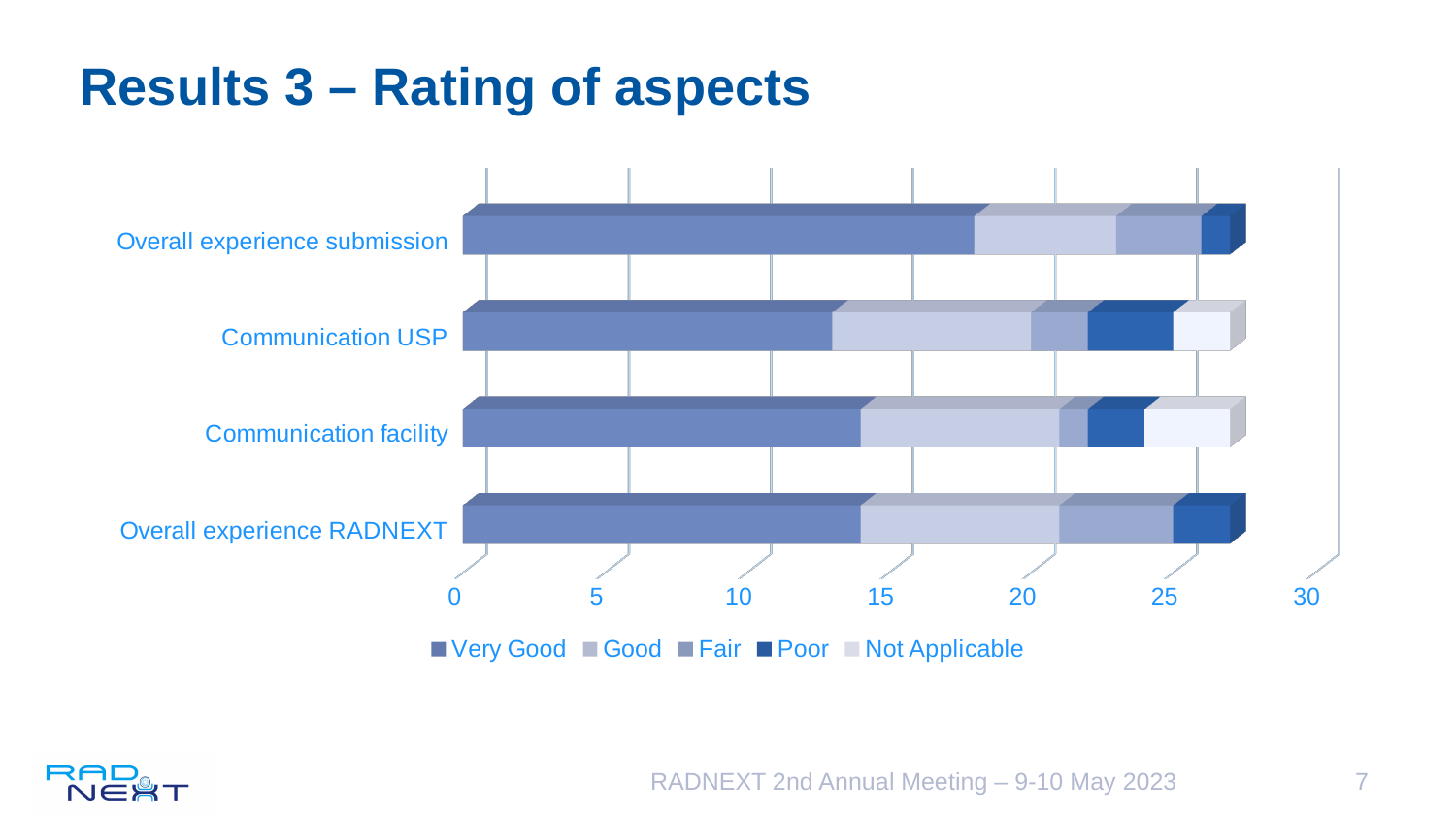
How many series does the legend list? 5 What kind of chart is shown on the slide? stacked bar chart Which rating categories are listed in the legend? Very Good, Good, Fair, Poor, Not Applicable How many categories (aspects) are plotted on the chart? 4 Is the 'Very Good' value for 'Communication USP' greater or less than 15? less Which aspects have a 'Not Applicable' segment? Communication USP and Communication facility Is the total length of the 'Overall experience RADNEXT' bar greater or less than 30? less Is the 'Very Good' value for 'Overall experience submission' greater or less than 15? greater Which aspect has the largest 'Very Good' segment? Overall experience submission What is the maximum value shown on the horizontal axis? 30 Which is larger, the 'Very Good' segment for 'Overall experience submission' or for 'Communication USP'? Overall experience submission